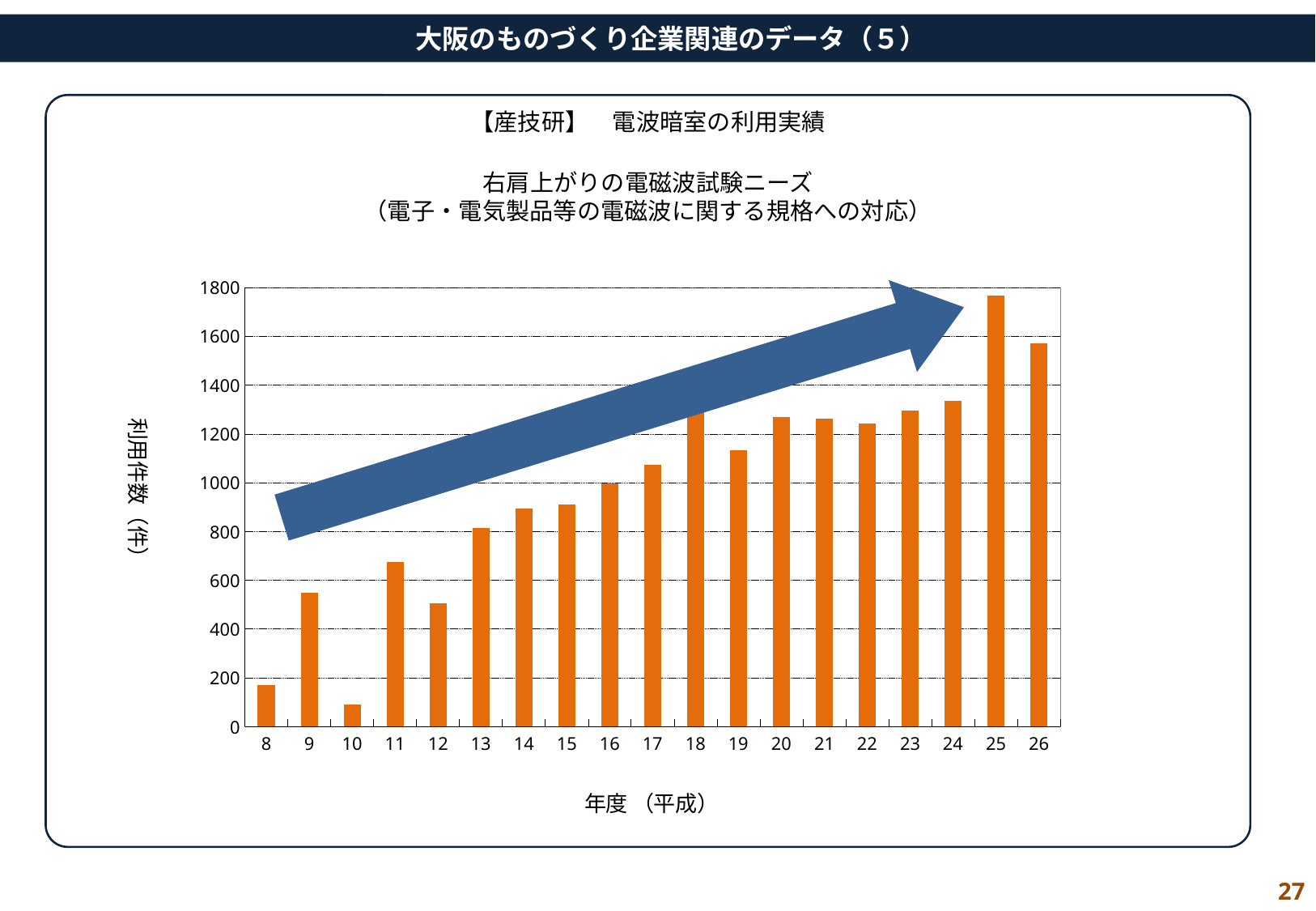
What kind of chart is shown on the slide? bar chart Which year (年度) has the lowest number of uses (利用件数)? 10 What is the label of the y axis? 利用件数（件） Which is larger, the value for year 11 or the value for year 12? year 11 How many years (年度) are plotted on the x axis? 19 Is the value for year 8 greater or less than 200? less Is the value for year 18 greater or less than 1200? greater Overall, do the values rise or fall from year 8 to year 26? rise Is the value for year 26 greater or less than 1400? greater Which year (年度) has the highest number of uses (利用件数)? 25